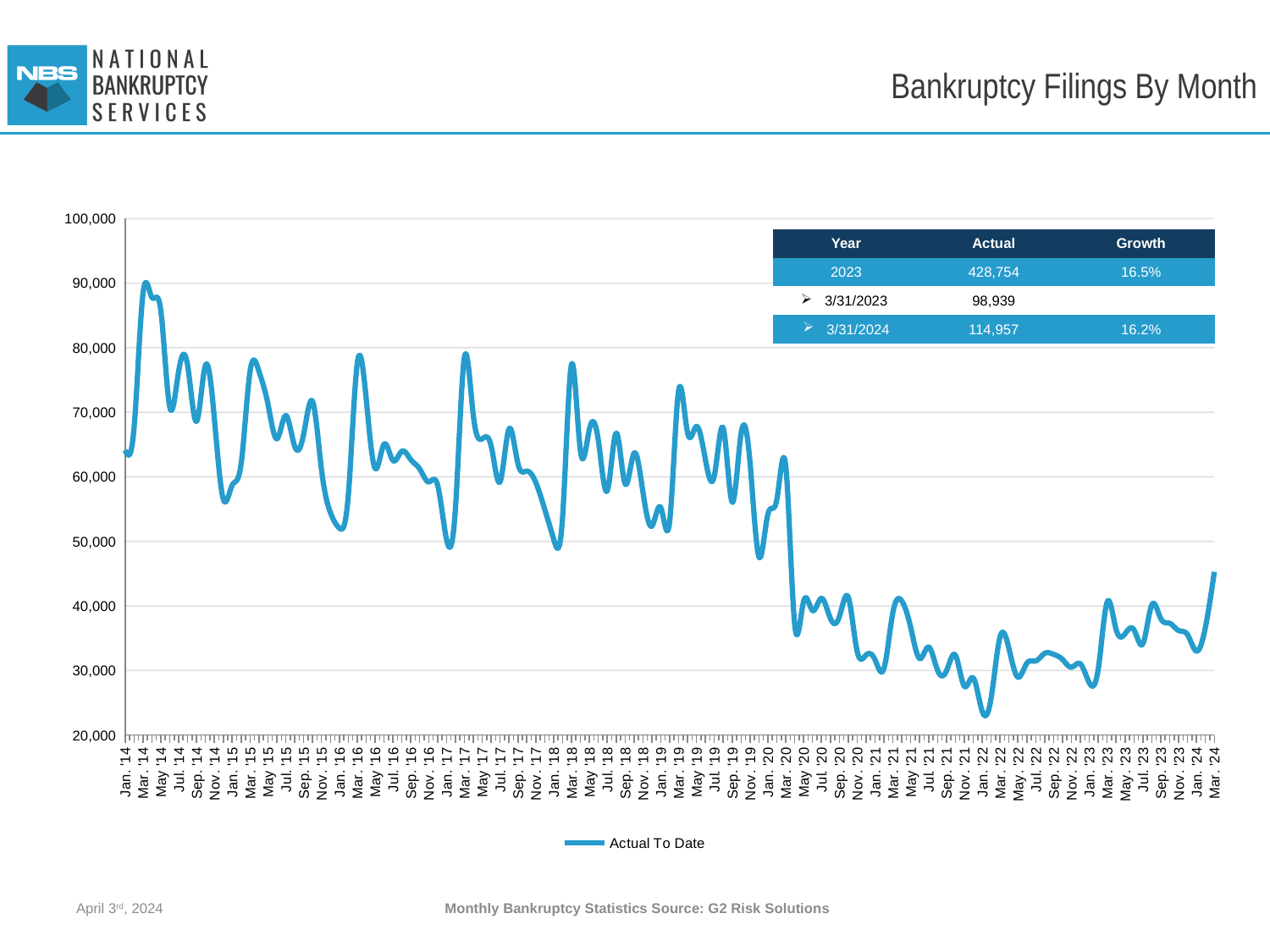
Overall, do the monthly bankruptcy filings rise or fall from Jan. '14 to Mar. '24? fall What kind of chart is shown on the slide? line chart Is the value for Jan. '22 greater or less than 30,000? less According to the table on the chart, what was the Actual value for 2023? 428,754 Is the value for Mar. '24 greater or less than 40,000? greater What is the name of the series shown in the legend? Actual To Date According to the table on the chart, what is the Growth shown for 3/31/2024? 16.2% How many series does the chart legend list? 1 What is the title of the chart? Bankruptcy Filings By Month Is the value for Jan. '14 greater or less than 60,000? greater